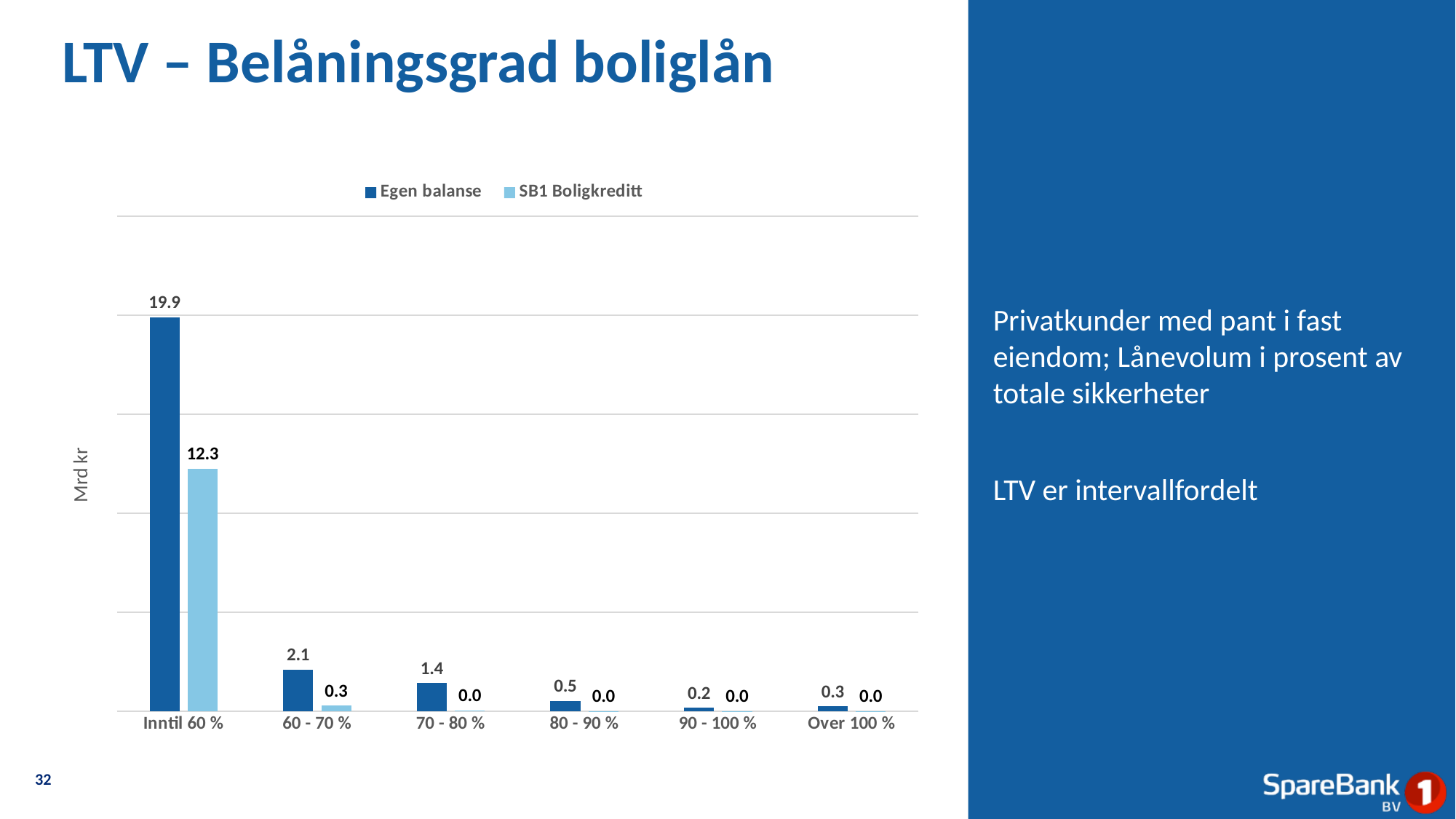
What is the value for Egen balanse in the 70 - 80 % category? 1.4 Which is larger for the 80 - 90 % category: Egen balanse or SB1 Boligkreditt? Egen balanse What is the difference between Egen balanse and SB1 Boligkreditt in the Inntil 60 % category? 7.6 Which category has the highest value for Egen balanse? Inntil 60 % What kind of chart is shown on the slide? Bar chart What is the value for SB1 Boligkreditt in the 60 - 70 % category? 0.3 How many series does the legend list? 2 What is the value for SB1 Boligkreditt in the Inntil 60 % category? 12.3 Which category has the lowest value for Egen balanse? 90 - 100 % What is the value for Egen balanse in the 60 - 70 % category? 2.1 How many LTV categories are shown on the x axis? 6 What is the value for Egen balanse in the Inntil 60 % category? 19.9